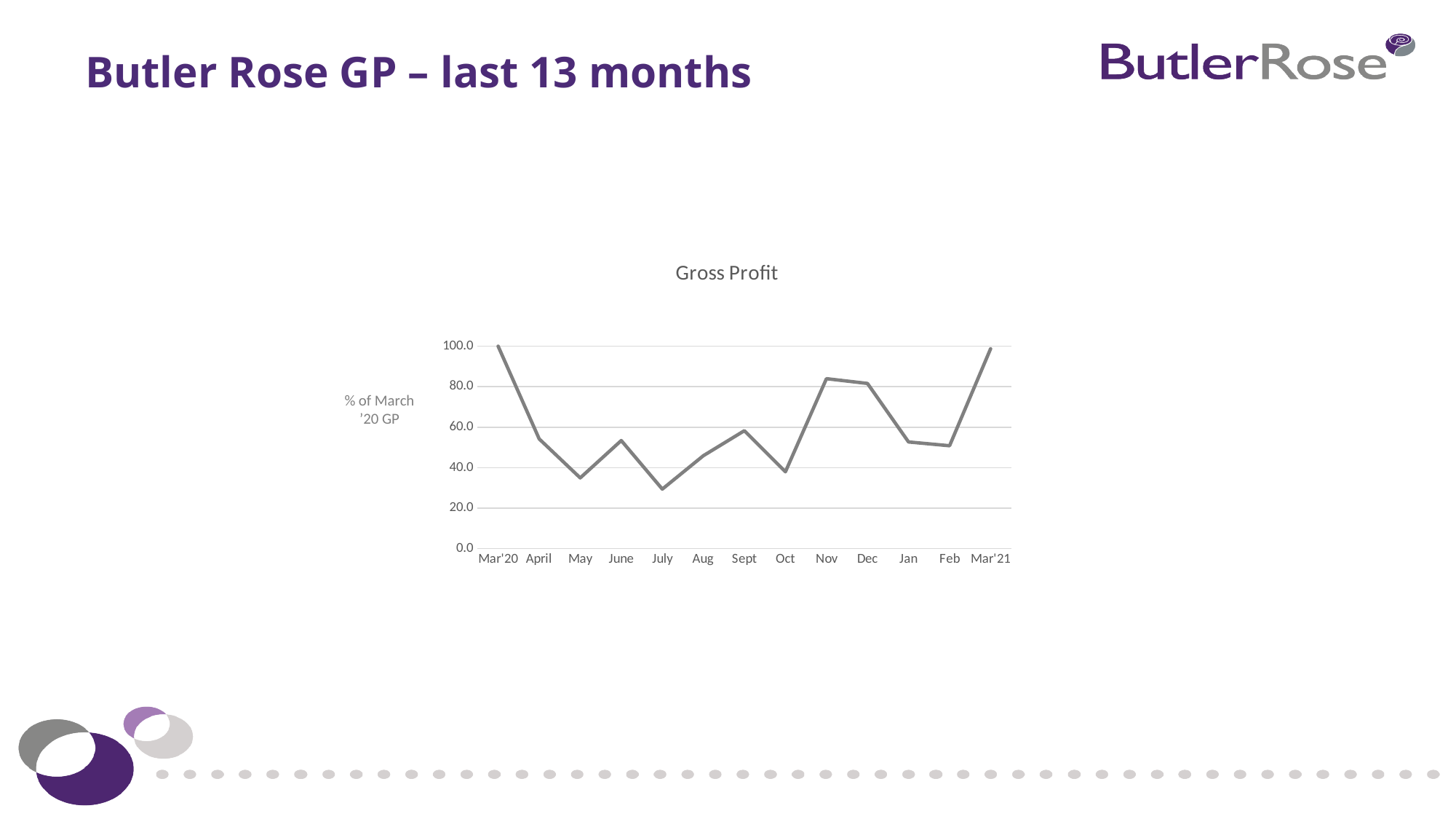
How many months are plotted on the x axis of the Gross Profit chart? 13 Which month has the lowest value in the Gross Profit chart? July Which is larger, the value for Nov or the value for Oct? Nov Does the value rise or fall from Mar'20 to April? fall Is the value for July greater or less than 40.0? less What is the title of the chart on the slide? Gross Profit What is the value for Mar'20 in the Gross Profit chart? 100.0 Is the value for April greater or less than 60.0? less What kind of chart is shown on the slide? line chart Is the value for Nov greater or less than 80.0? greater Which is larger, the value for Sept or the value for July? Sept